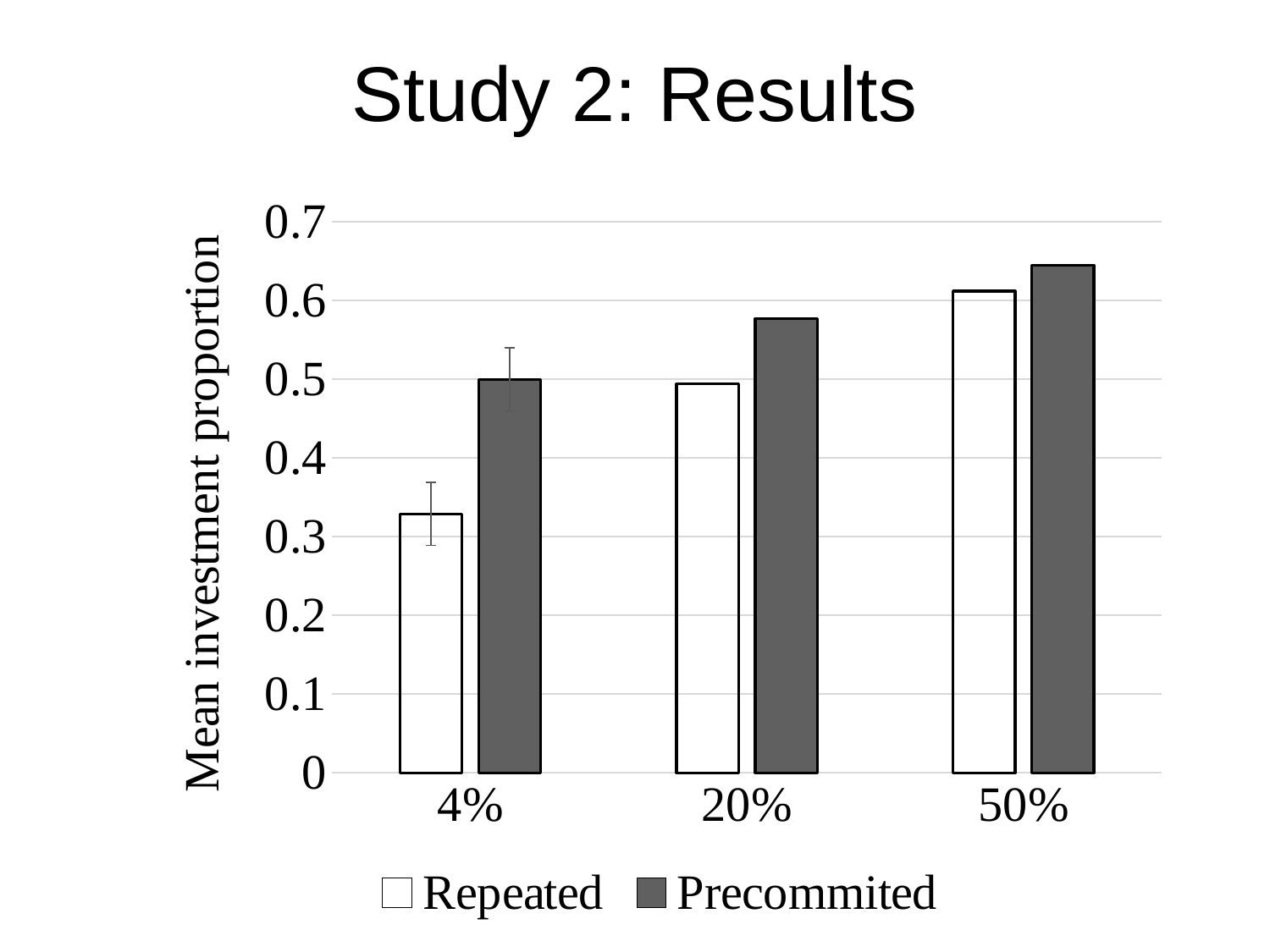
Which category has the highest Precommited value? 50% Which category has the lowest Repeated value? 4% Is the Repeated value for 50% greater or less than 0.6? greater Is the Repeated value for 4% greater or less than 0.4? less What is the label of the y axis? Mean investment proportion How many categories are shown on the x axis? 3 How many series does the legend list? 2 Is the Precommited value for 20% greater or less than 0.5? greater Do the Repeated values rise or fall as the x axis goes from 4% to 50%? rise For the 4% category, which series has the larger value, Repeated or Precommited? Precommited What kind of chart is shown on the slide? bar chart